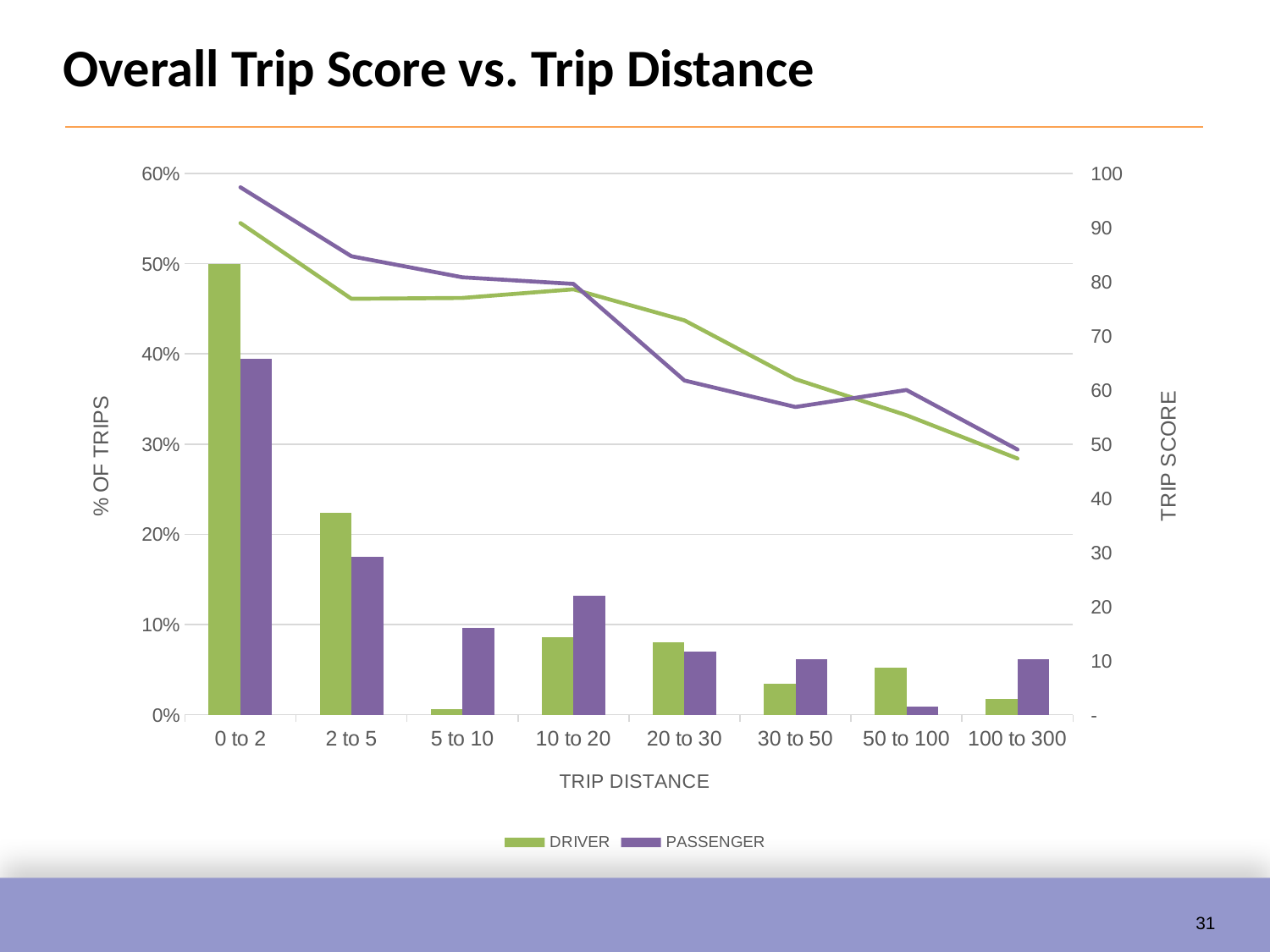
Do the trip score lines rise or fall as trip distance increases? fall Which trip distance category has the highest Driver % of trips? 0 to 2 Which trip distance category has the lowest Driver % of trips? 5 to 10 Is the Passenger trip score for 0 to 2 greater or less than 90? greater What is the Driver % of trips for the 0 to 2 distance category? 50% In the 0 to 2 category, which bar is taller, Driver or Passenger? Driver How many series does the legend list? 2 Is the Passenger % of trips for 10 to 20 greater or less than 10%? greater In the 5 to 10 category, which bar is taller, Driver or Passenger? Passenger What kind of chart is shown on the slide? A combination bar and line chart What is the title of the right-hand vertical axis? TRIP SCORE How many trip distance categories are shown on the x axis? 8